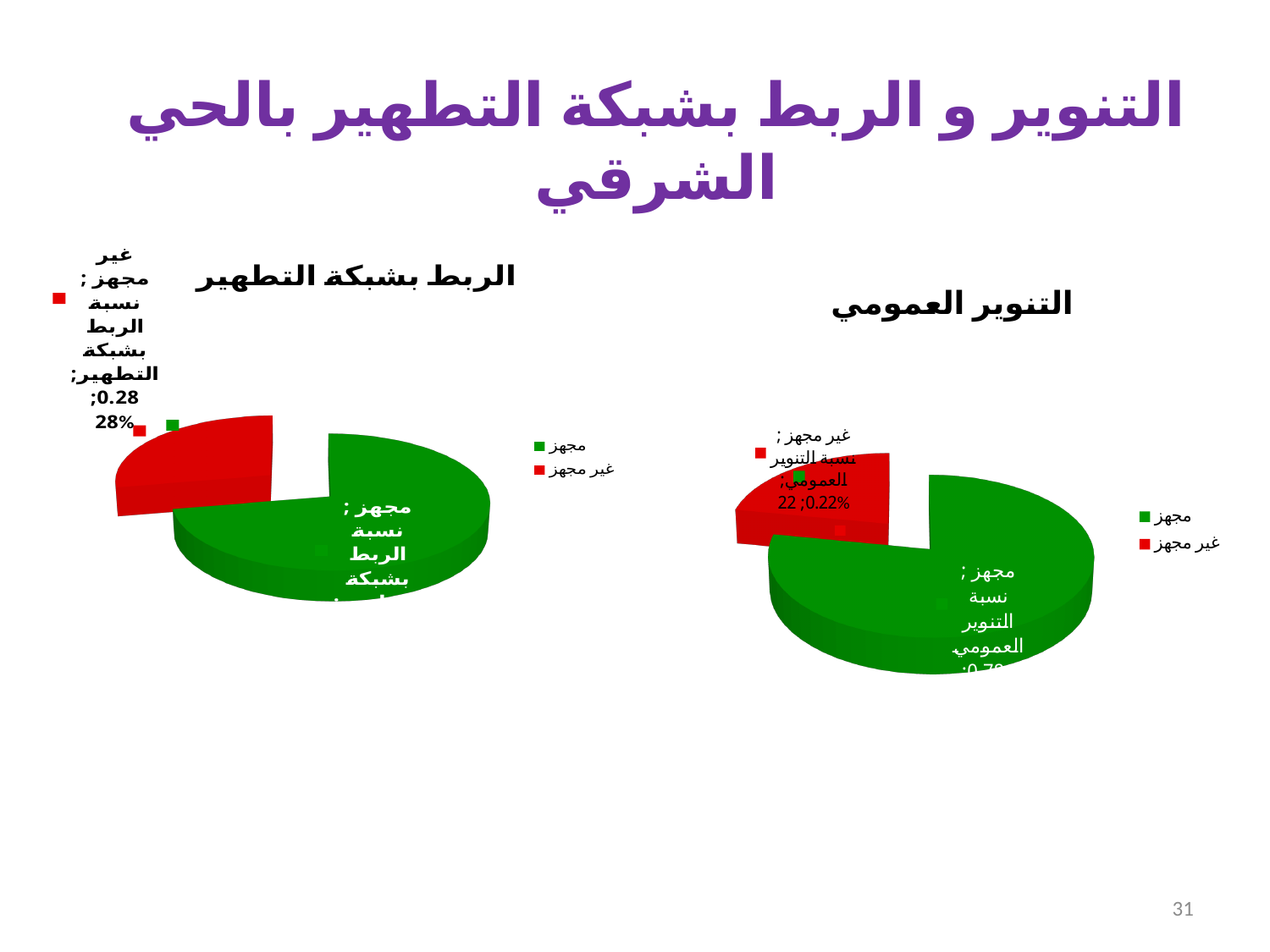
How many slices does the chart titled "الربط بشبكة التطهير" have? 2 In the chart titled "التنوير العمومي", what percentage is shown for the "غير مجهز" slice? 22% In the chart titled "الربط بشبكة التطهير", what colour is the "غير مجهز" slice? red In the chart titled "التنوير العمومي", which slice is larger, "مجهز" or "غير مجهز"? مجهز What kind of chart is the chart titled "الربط بشبكة التطهير"? pie chart What kind of chart is the chart titled "التنوير العمومي"? pie chart How many entries does the legend of the chart titled "التنوير العمومي" list? 2 In the chart titled "الربط بشبكة التطهير", which slice is the largest? مجهز In the chart titled "الربط بشبكة التطهير", what percentage is shown for the "غير مجهز" slice? 28% What is the difference between the "غير مجهز" percentage in the chart titled "الربط بشبكة التطهير" and the "غير مجهز" percentage in the chart titled "التنوير العمومي"? 6% What is the title of the chart on the right side of the slide? التنوير العمومي In the chart titled "التنوير العمومي", which slice is the smallest? غير مجهز